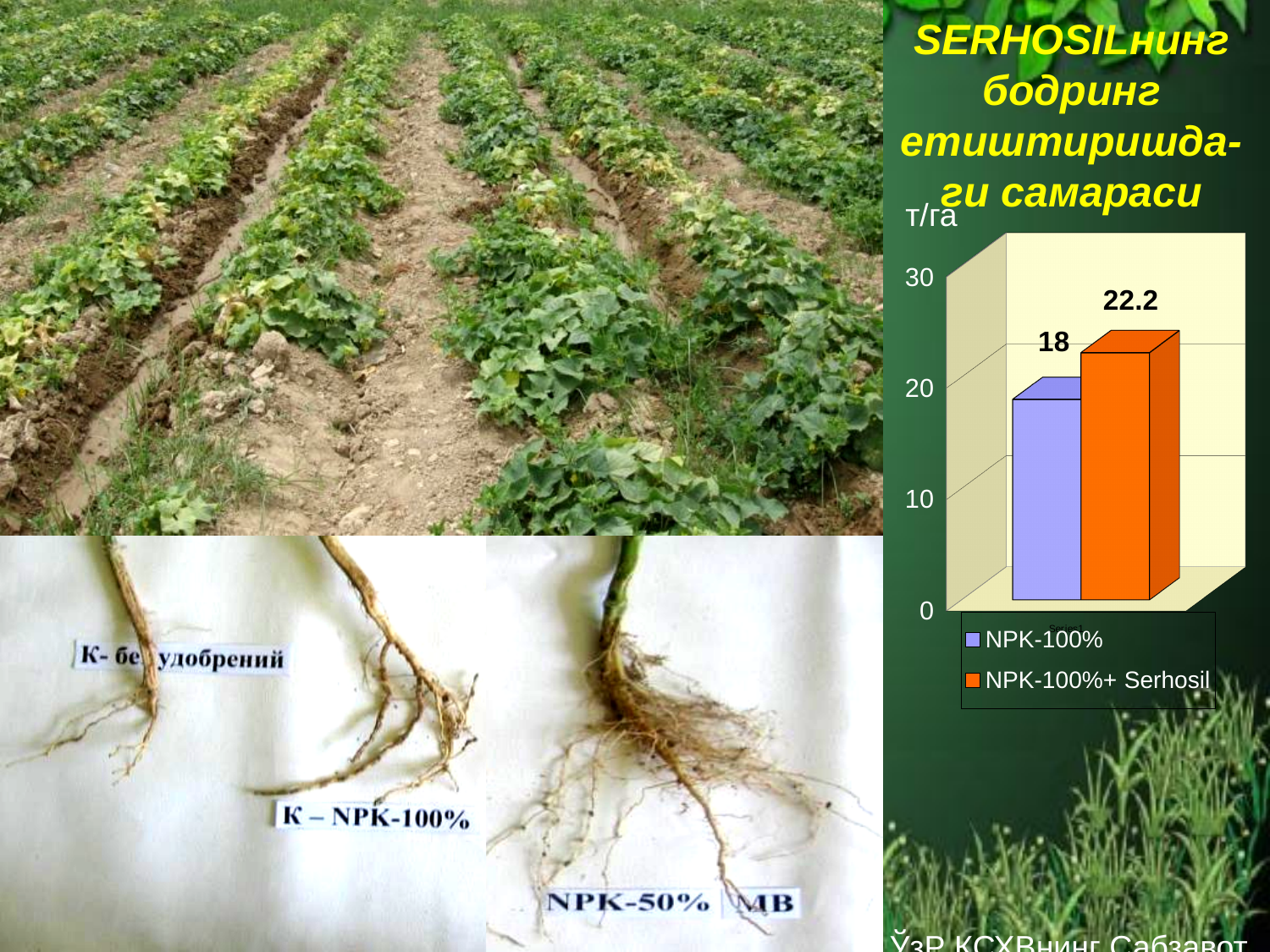
What unit is shown above the chart's vertical axis? т/га Which series has the lowest value in the chart? NPK-100% What is the value for NPK-100% in the chart? 18 What kind of chart is shown on the slide? bar chart What is the value for NPK-100%+ Serhosil in the chart? 22.2 How many series does the chart legend list? 2 What is the difference between the NPK-100%+ Serhosil value and the NPK-100% value? 4.2 What colour is the bar for NPK-100%+ Serhosil? orange Is the value for NPK-100%+ Serhosil greater or less than 20? greater Which series has the highest value in the chart? NPK-100%+ Serhosil Which series has the higher value, NPK-100% or NPK-100%+ Serhosil? NPK-100%+ Serhosil Is the value for NPK-100% greater or less than 20? less